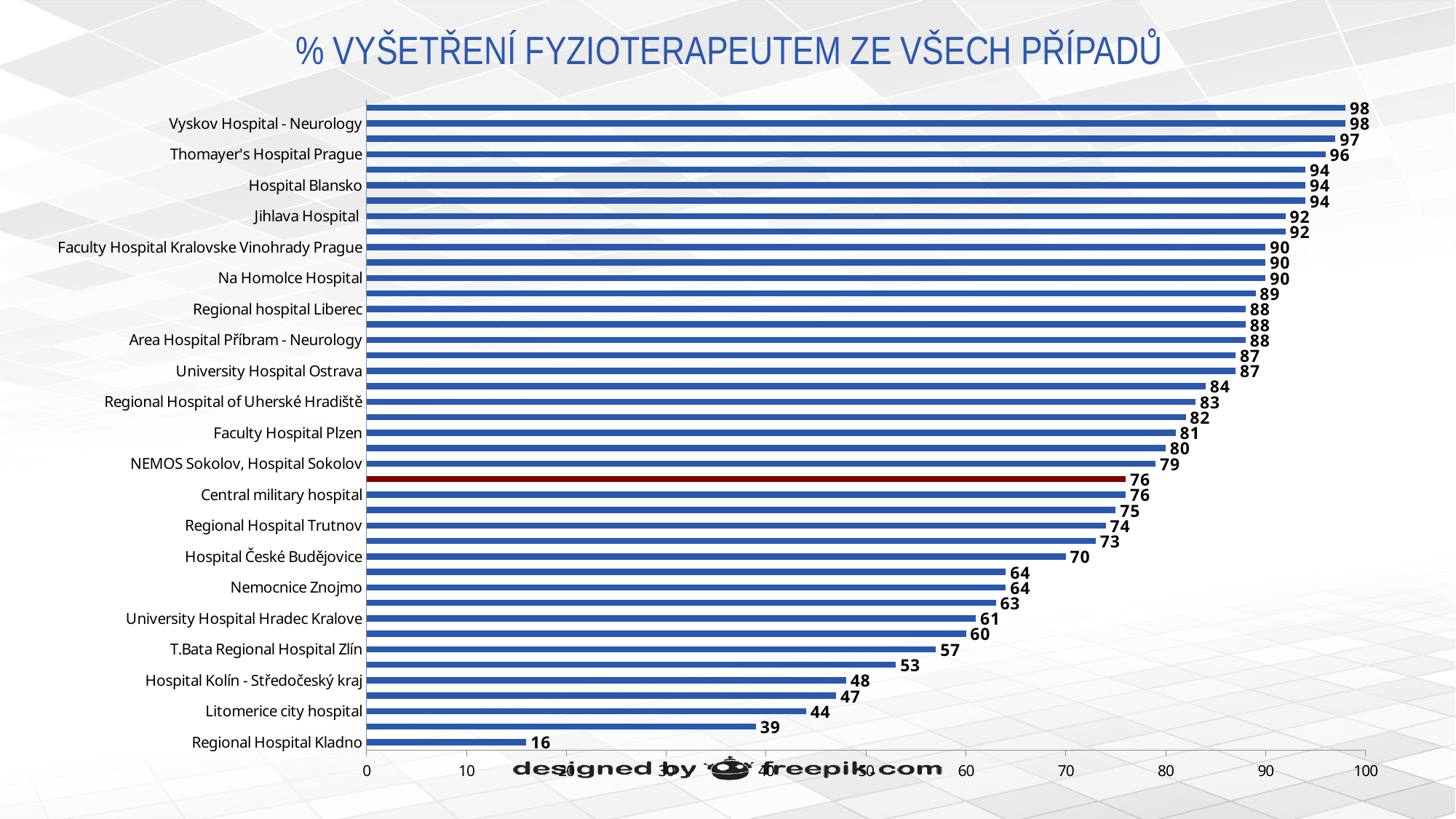
What is the value for Area Hospital Příbram - Neurology? 88 What is the difference between the values for Vyskov Hospital - Neurology and Regional Hospital Kladno? 82 What is the value for Hospital Blansko? 94 Which has a larger value, Vyskov Hospital - Neurology or Nemocnice Znojmo? Vyskov Hospital - Neurology What type of chart is shown on the slide? bar chart What is the title of the chart? % VYŠETŘENÍ FYZIOTERAPEUTEM ZE VŠECH PŘÍPADŮ Which hospital has the lowest value? Regional Hospital Kladno What is the value for University Hospital Ostrava? 87 What is the value for Nemocnice Znojmo? 64 Is the value for Regional Hospital Kladno greater or less than 20? less What is the value for Vyskov Hospital - Neurology? 98